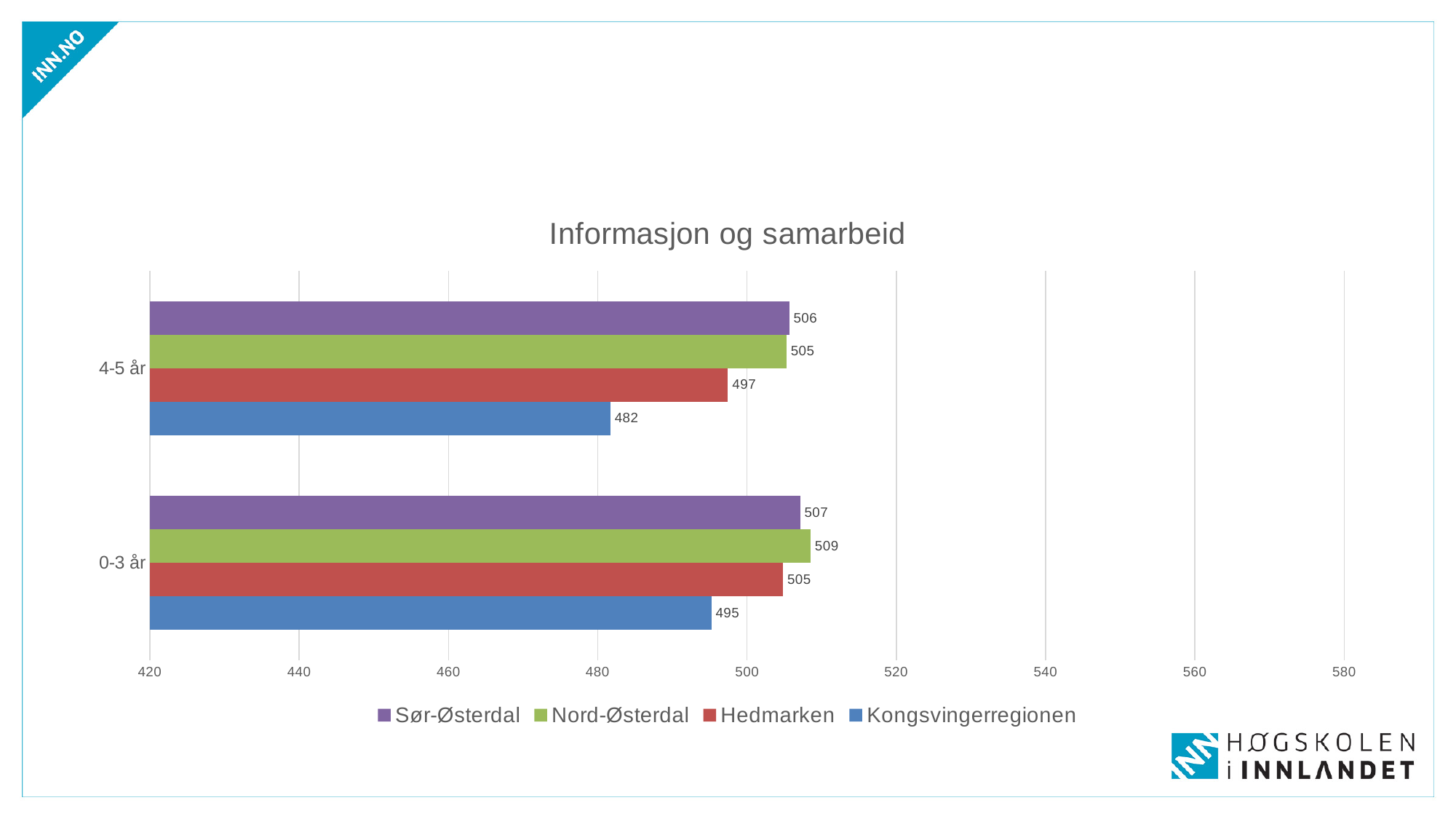
How many age categories are shown on the chart? 2 What is the value for Kongsvingerregionen in the 0-3 år category? 495 What is the difference between the Kongsvingerregionen values for 0-3 år and 4-5 år? 13 What is the value for Hedmarken in the 4-5 år category? 497 How many series does the legend list? 4 Which series has the highest value in the 0-3 år category? Nord-Østerdal What is the value for Sør-Østerdal in the 4-5 år category? 506 Is the value for Kongsvingerregionen in the 4-5 år category greater or less than 500? less Which series has the lowest value in the 4-5 år category? Kongsvingerregionen Which is larger: Hedmarken for 0-3 år or Hedmarken for 4-5 år? Hedmarken for 0-3 år What kind of chart is shown on the slide? Bar chart What is the title of the chart? Informasjon og samarbeid